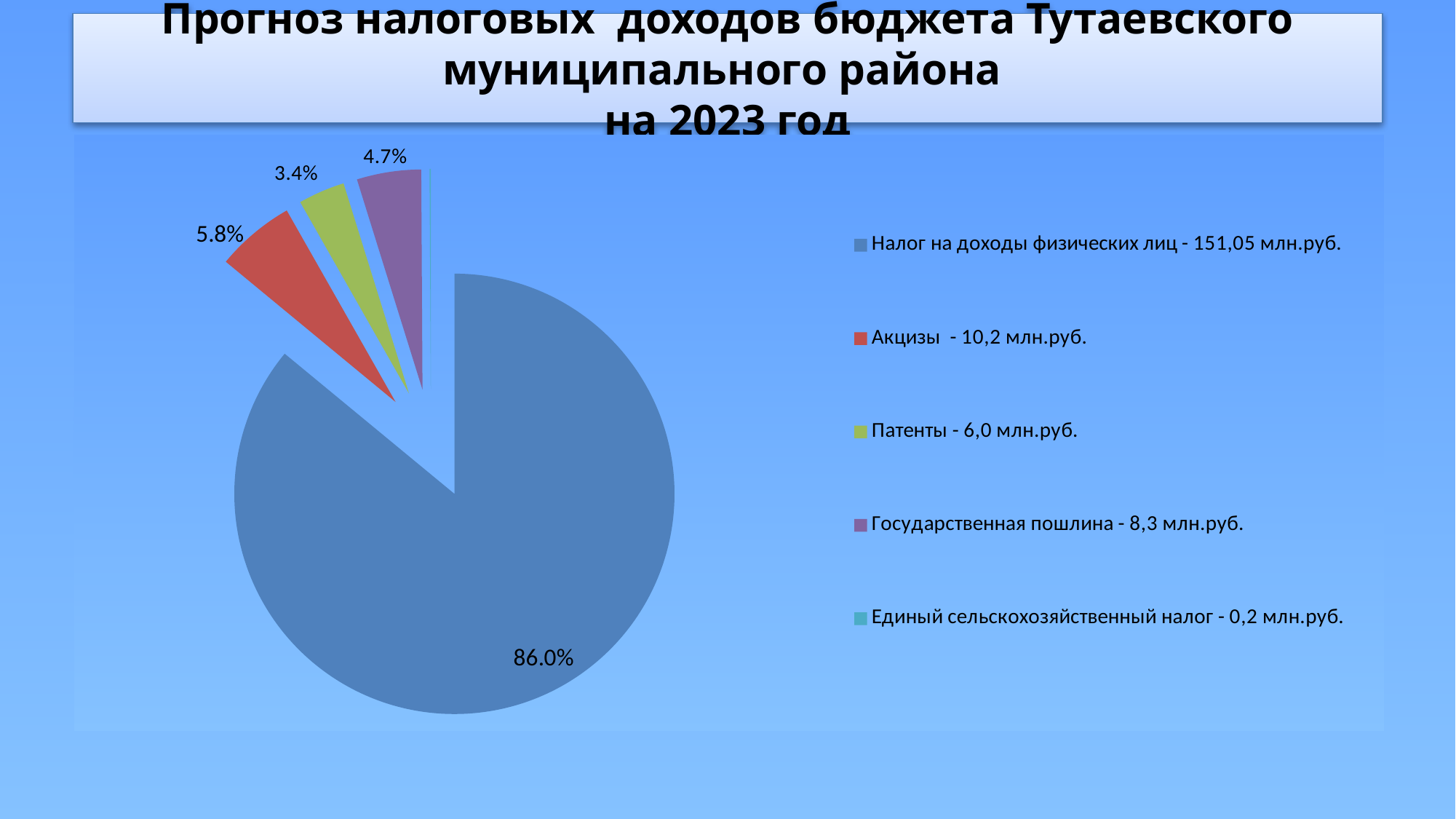
What share of the pie does Акцизы take? 5.8% What is the difference between the legend amounts for Акцизы and Государственная пошлина? 1,9 млн.руб. According to the legend, what is the forecast amount for Акцизы? 10,2 млн.руб. How many categories does the legend of the pie chart list? 5 What kind of chart is shown on the slide? pie chart What share of the pie does Налог на доходы физических лиц take? 86.0% According to the legend, what is the forecast amount for Единый сельскохозяйственный налог? 0,2 млн.руб. Which is larger: the share for Акцизы or the share for Государственная пошлина? Акцизы Which category has the largest slice of the pie? Налог на доходы физических лиц Which category has the smallest amount according to the legend? Единый сельскохозяйственный налог What share of the pie does Патенты take? 3.4%